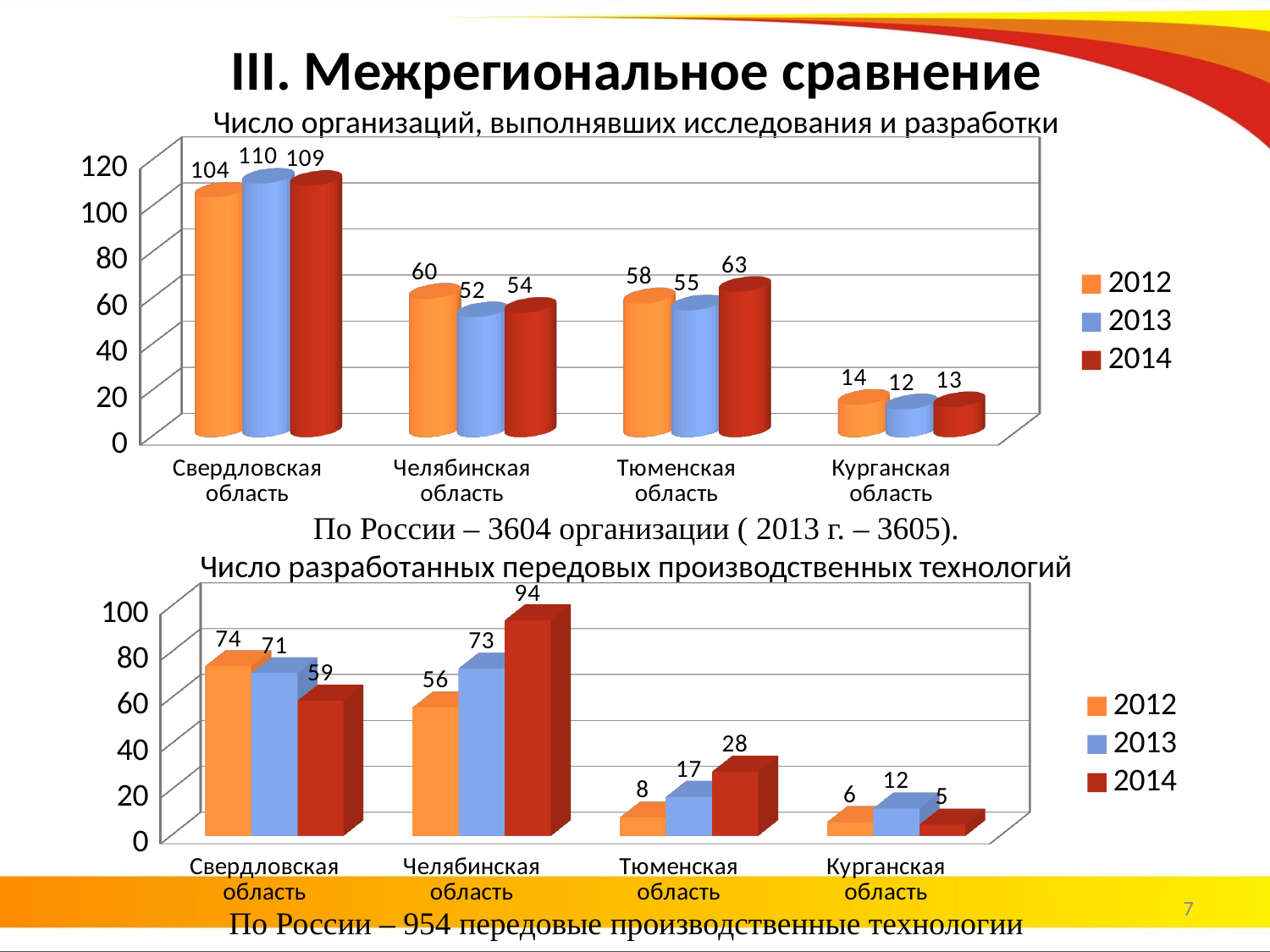
In the top chart 'Число организаций, выполнявших исследования и разработки', what is the value for Тюменская область in 2014? 63 What kind of chart is the bottom chart 'Число разработанных передовых производственных технологий'? Bar chart In the bottom chart 'Число разработанных передовых производственных технологий', which is larger for Свердловская область: the 2012 value or the 2014 value? 2012 In the bottom chart 'Число разработанных передовых производственных технологий', do the values for Свердловская область rise or fall from 2012 to 2014? Fall In the top chart 'Число организаций, выполнявших исследования и разработки', which region has the lowest value in 2012? Курганская область In the bottom chart 'Число разработанных передовых производственных технологий', what is the value for Челябинская область in 2014? 94 In the top chart 'Число организаций, выполнявших исследования и разработки', what is the difference between the 2012 and 2013 values for Челябинская область? 8 In the top chart 'Число организаций, выполнявших исследования и разработки', how many series does the legend list? 3 In the bottom chart 'Число разработанных передовых производственных технологий', which region has the highest value in 2014? Челябинская область In the bottom chart 'Число разработанных передовых производственных технологий', what is the difference between the 2014 and 2012 values for Тюменская область? 20 In the top chart 'Число организаций, выполнявших исследования и разработки', what is the value for Свердловская область in 2013? 110 In the bottom chart 'Число разработанных передовых производственных технологий', how many regions are shown on the x axis? 4